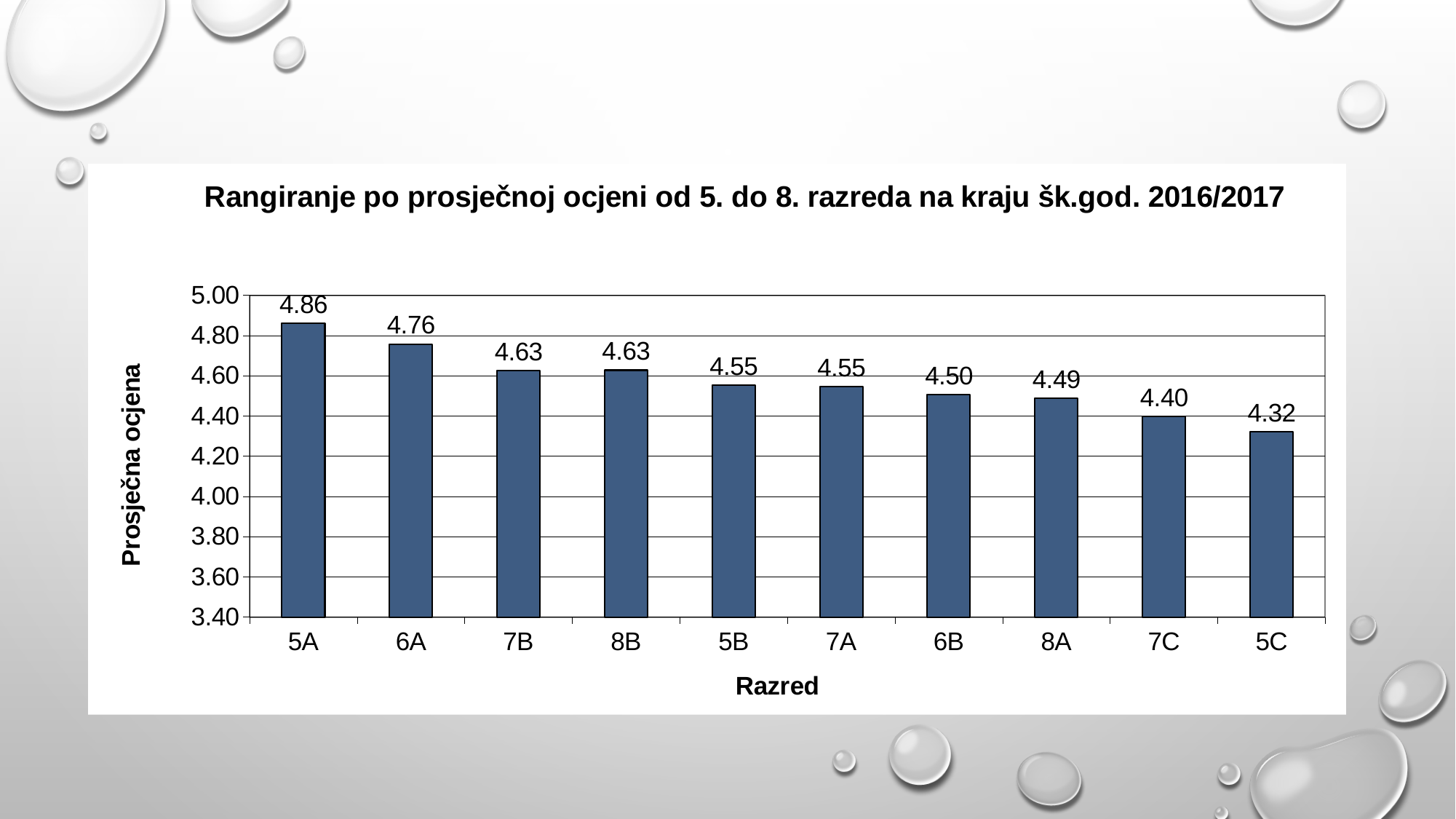
Which class has a higher average grade, 6A or 7C? 6A Do the values rise or fall from left to right along the x axis? fall Which class has the lowest average grade? 5C What kind of chart is shown on the slide? bar chart What is the difference between the average grades of 6A and 8A? 0.27 What is the average grade shown for class 7C? 4.40 What is the average grade (prosječna ocjena) for class 5A? 4.86 Which class has the highest average grade? 5A What is the difference between the average grades of 5A and 5C? 0.54 What is the average grade shown for class 6B? 4.50 How many classes are shown on the x axis? 10 Is the value for 5C greater or less than 4.40? less